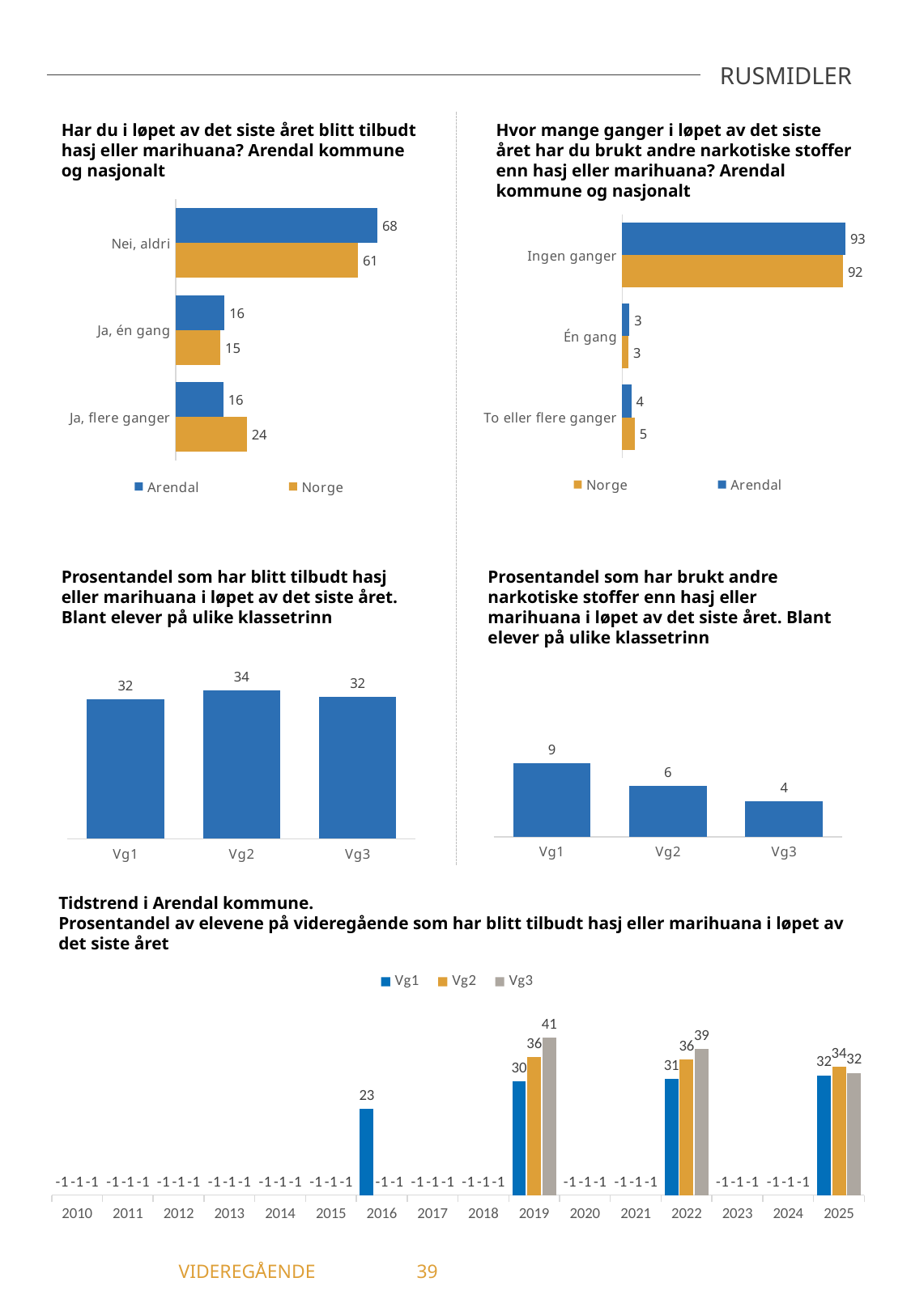
In the top-left chart 'Har du i løpet av det siste året blitt tilbudt hasj eller marihuana?', what is the difference between the Arendal and Norge values for 'Nei, aldri'? 7 In the bottom chart 'Tidstrend i Arendal kommune', what is the value for Vg1 in 2016? 23 In the middle-right chart 'Prosentandel som har brukt andre narkotiske stoffer enn hasj eller marihuana i løpet av det siste året', what is the value for Vg1? 9 In the top-right chart 'Hvor mange ganger i løpet av det siste året har du brukt andre narkotiske stoffer enn hasj eller marihuana?', what is the value for Arendal for 'Ingen ganger'? 93 In the top-right chart 'Hvor mange ganger i løpet av det siste året har du brukt andre narkotiske stoffer enn hasj eller marihuana?', how many series does the legend list? 2 In the top-left chart 'Har du i løpet av det siste året blitt tilbudt hasj eller marihuana?', what is the value for Arendal for 'Nei, aldri'? 68 In the top-left chart 'Har du i løpet av det siste året blitt tilbudt hasj eller marihuana?', what is the value for Norge for 'Ja, flere ganger'? 24 What kind of chart is the bottom chart 'Tidstrend i Arendal kommune'? bar chart In the middle-right chart 'Prosentandel som har brukt andre narkotiske stoffer enn hasj eller marihuana i løpet av det siste året', do the values rise or fall from Vg1 to Vg3? fall In the bottom chart 'Tidstrend i Arendal kommune', what is the value for Vg3 in 2019? 41 In the middle-left chart 'Prosentandel som har blitt tilbudt hasj eller marihuana i løpet av det siste året', which class level has the highest value? Vg2 In the top-right chart 'Hvor mange ganger i løpet av det siste året har du brukt andre narkotiske stoffer enn hasj eller marihuana?', which is larger for 'To eller flere ganger', Norge or Arendal? Norge